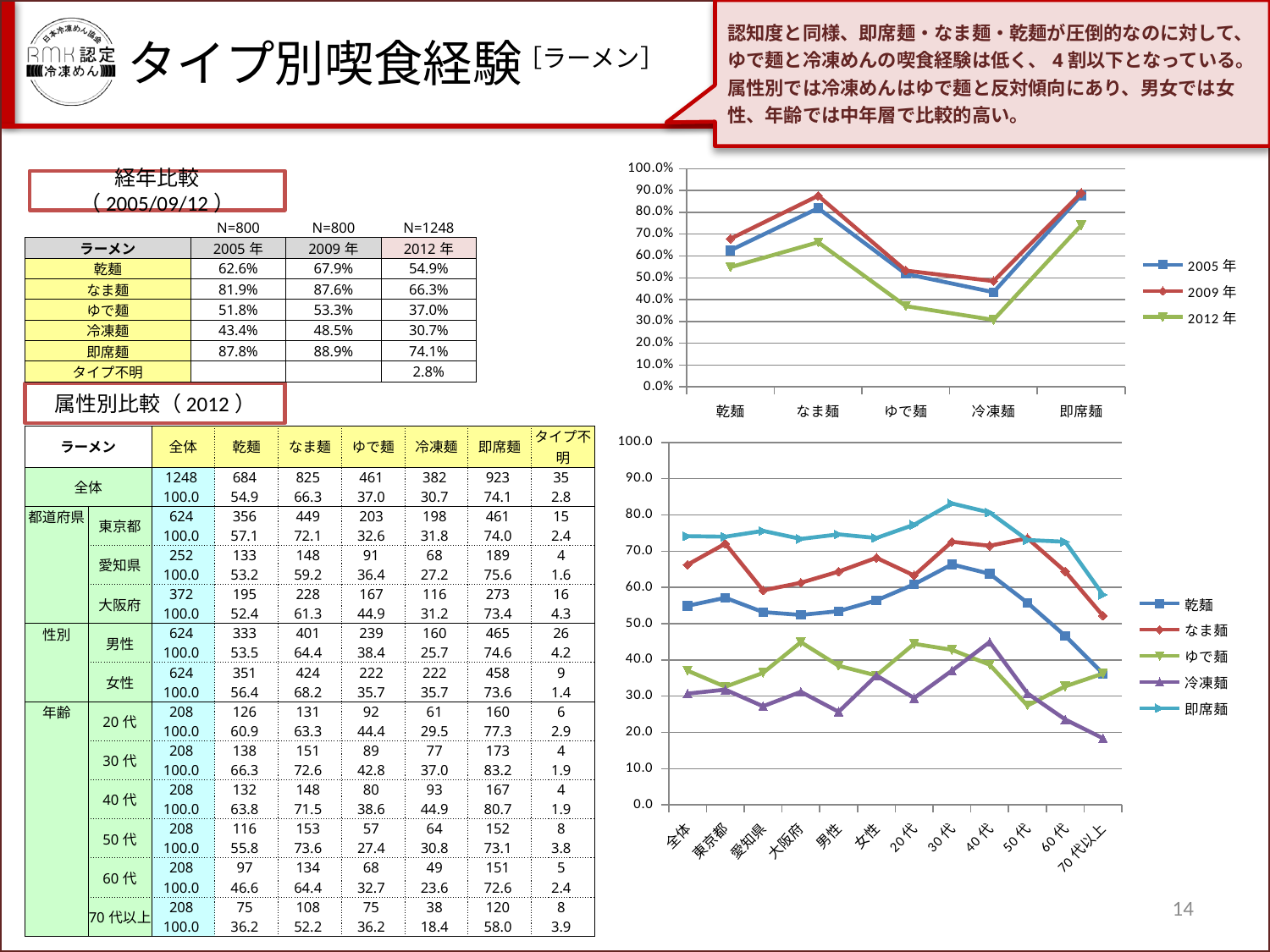
In the upper chart, which category has the highest value for the 2012年 series? 即席麺 How many categories are shown on the x axis of the upper chart? 5 How many categories are shown on the x axis of the lower chart? 12 In the upper chart, which category has the lowest value for the 2012年 series? 冷凍麺 How many series does the legend of the upper chart list? 3 What kind of chart is the upper chart on the right (the one with series 2005年, 2009年, 2012年)? line chart In the upper chart, is the 2012年 value for ゆで麺 greater or less than 40.0%? less In the lower chart, which series has the highest value at 30代? 即席麺 In the upper chart, what is the 2012年 value for 乾麺 (as given in the accompanying table)? 54.9% In the upper chart, which series has the larger value for なま麺: 2005年 or 2009年? 2009年 In the lower chart, is the 冷凍麺 value for 70代以上 greater or less than 20.0? less How many series does the legend of the lower chart list? 5